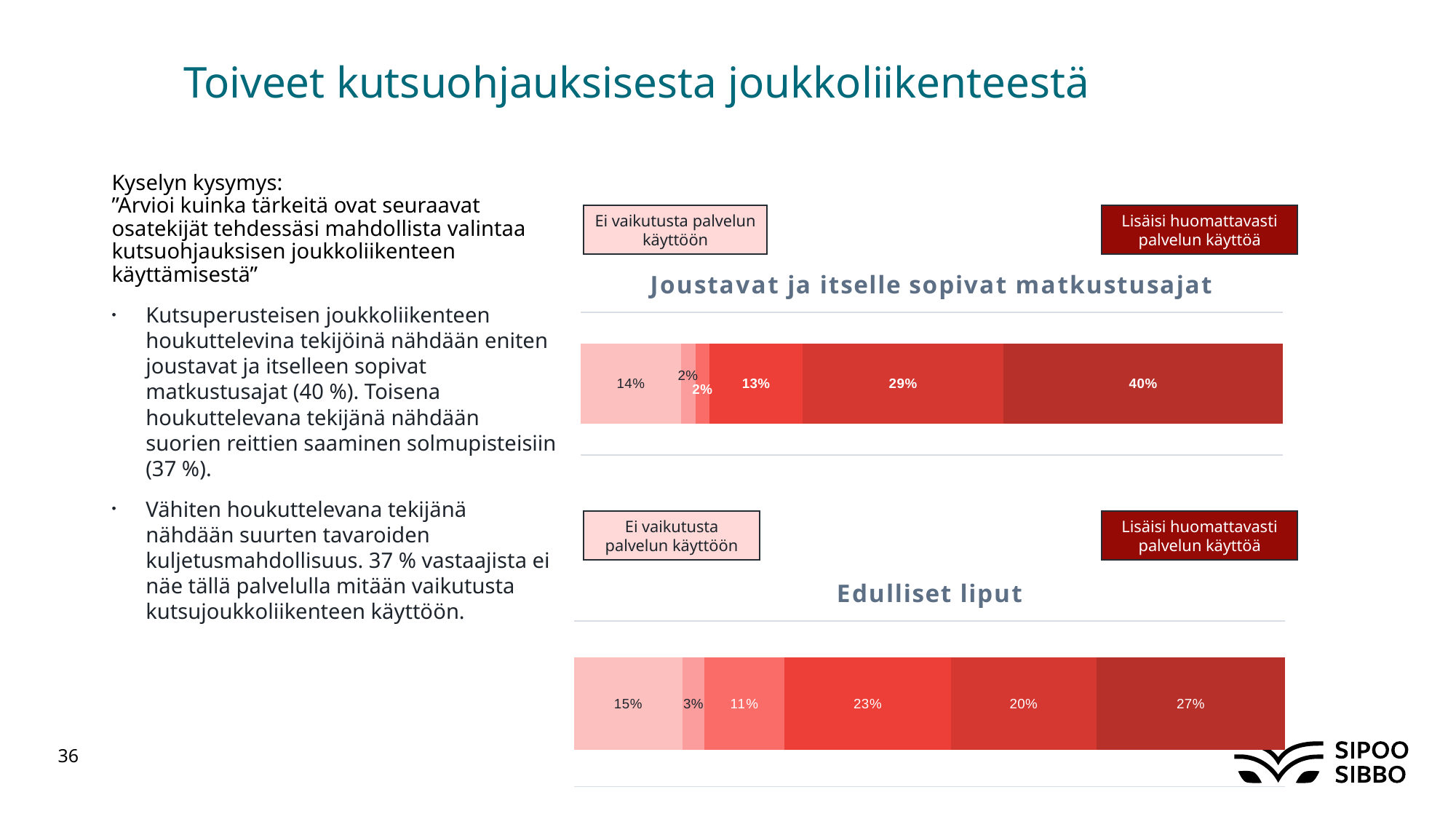
Which chart has the larger rightmost (darkest) segment: "Joustavat ja itselle sopivat matkustusajat" or "Edulliset liput"? Joustavat ja itselle sopivat matkustusajat What is the difference between the rightmost segment of "Joustavat ja itselle sopivat matkustusajat" (40%) and the rightmost segment of "Edulliset liput" (27%)? 13 percentage points What label appears in the box at the right end of each chart? Lisäisi huomattavasti palvelun käyttöä In the "Edulliset liput" chart, what is the value of the middle red segment between 11% and 20%? 23% What label appears in the box at the left end of each chart? Ei vaikutusta palvelun käyttöön In the "Edulliset liput" chart, what is the value of the leftmost (lightest) segment? 15% In the "Joustavat ja itselle sopivat matkustusajat" chart, what is the value of the largest (darkest, rightmost) segment? 40% In the "Edulliset liput" chart, which segment has the smallest value? 3% How many segments does the bar in the "Edulliset liput" chart have? 6 In the "Edulliset liput" chart, what is the value of the rightmost (darkest) segment? 27% What kind of chart is used for "Joustavat ja itselle sopivat matkustusajat"? Stacked bar chart In the "Joustavat ja itselle sopivat matkustusajat" chart, what is the value of the leftmost (lightest) segment? 14%